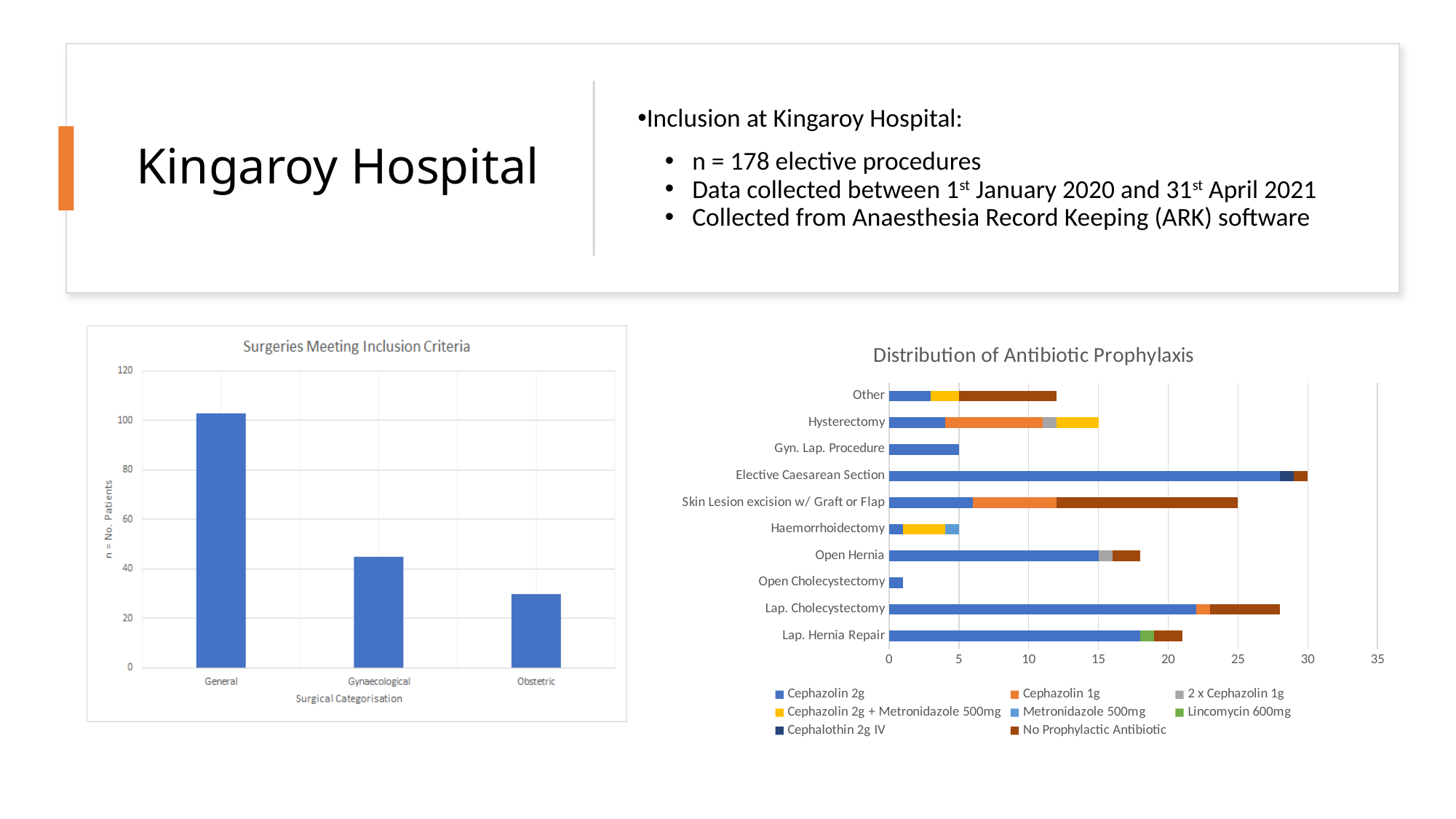
In the 'Surgeries Meeting Inclusion Criteria' chart, do the values rise or fall from General to Obstetric along the x axis? fall What type of chart is the 'Surgeries Meeting Inclusion Criteria' chart? bar chart In the 'Surgeries Meeting Inclusion Criteria' chart, is the value for Obstetric greater or less than 40? less In the 'Surgeries Meeting Inclusion Criteria' chart, which surgical category has the highest number of patients? General In the 'Distribution of Antibiotic Prophylaxis' chart, which is larger: the total bar for Skin Lesion excision w/ Graft or Flap or the total bar for Open Hernia? Skin Lesion excision w/ Graft or Flap In the 'Surgeries Meeting Inclusion Criteria' chart, which surgical category has the lowest number of patients? Obstetric In the 'Distribution of Antibiotic Prophylaxis' chart, which procedure has the shortest total bar? Open Cholecystectomy In the 'Distribution of Antibiotic Prophylaxis' chart, how many procedure categories are shown? 10 In the 'Surgeries Meeting Inclusion Criteria' chart, how many surgical categories are shown? 3 In the 'Distribution of Antibiotic Prophylaxis' chart, is the total bar for Elective Caesarean Section greater or less than 25? greater In the 'Distribution of Antibiotic Prophylaxis' chart, how many series does the legend list? 8 In the 'Surgeries Meeting Inclusion Criteria' chart, is the value for General greater or less than 80? greater